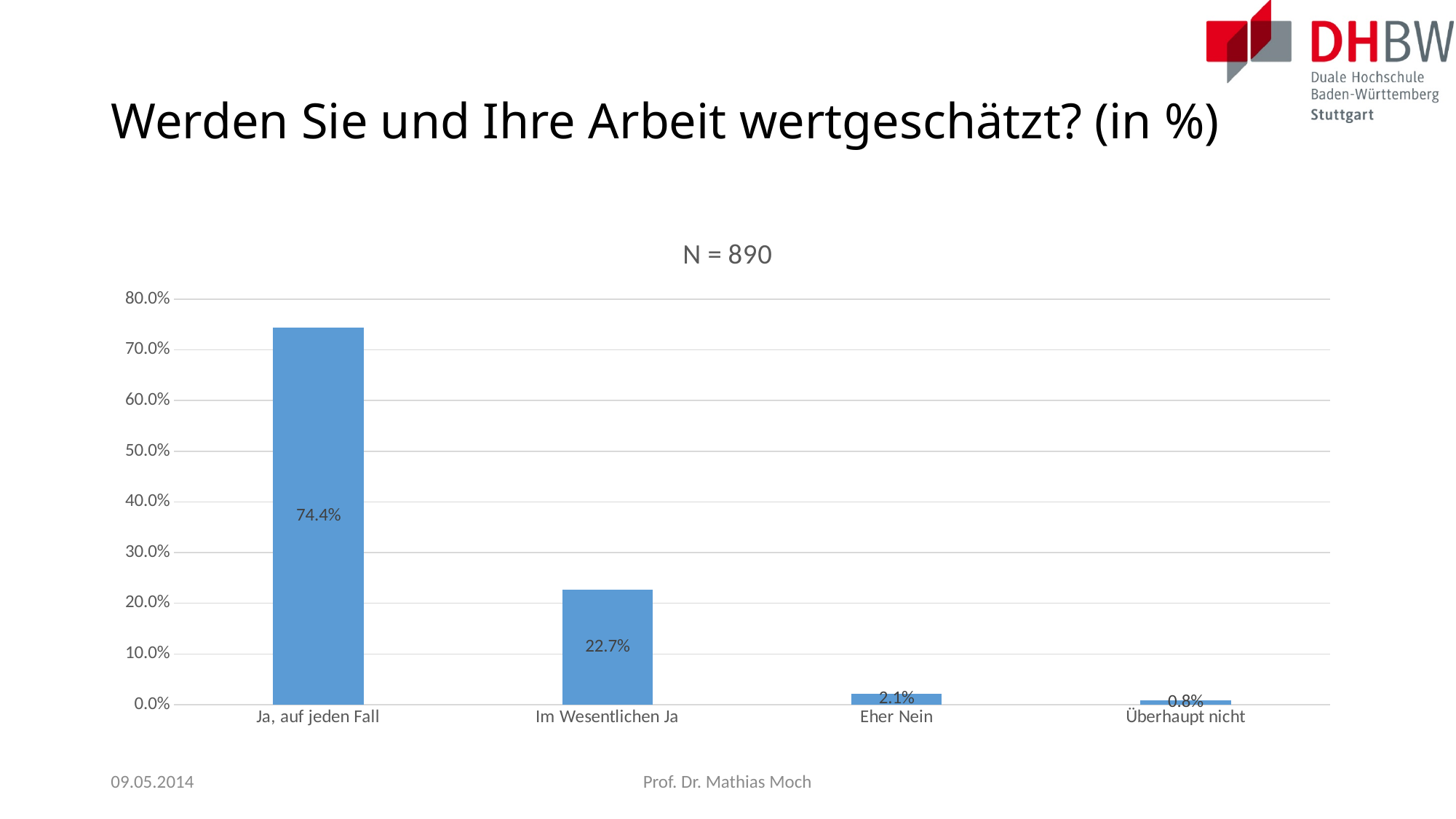
Which category has the lowest value? Überhaupt nicht What is the title shown above the chart? N = 890 What is the value for "Überhaupt nicht"? 0.8% How many categories are shown on the x axis? 4 What kind of chart is shown on the slide? bar chart Is the value for "Im Wesentlichen Ja" greater or less than 30.0%? less What is the value for "Eher Nein"? 2.1% What is the value for "Ja, auf jeden Fall"? 74.4% Which category has the highest value? Ja, auf jeden Fall Which is larger, the value for "Eher Nein" or the value for "Überhaupt nicht"? Eher Nein What is the difference between the values for "Ja, auf jeden Fall" and "Im Wesentlichen Ja"? 51.7% What is the value for "Im Wesentlichen Ja"? 22.7%